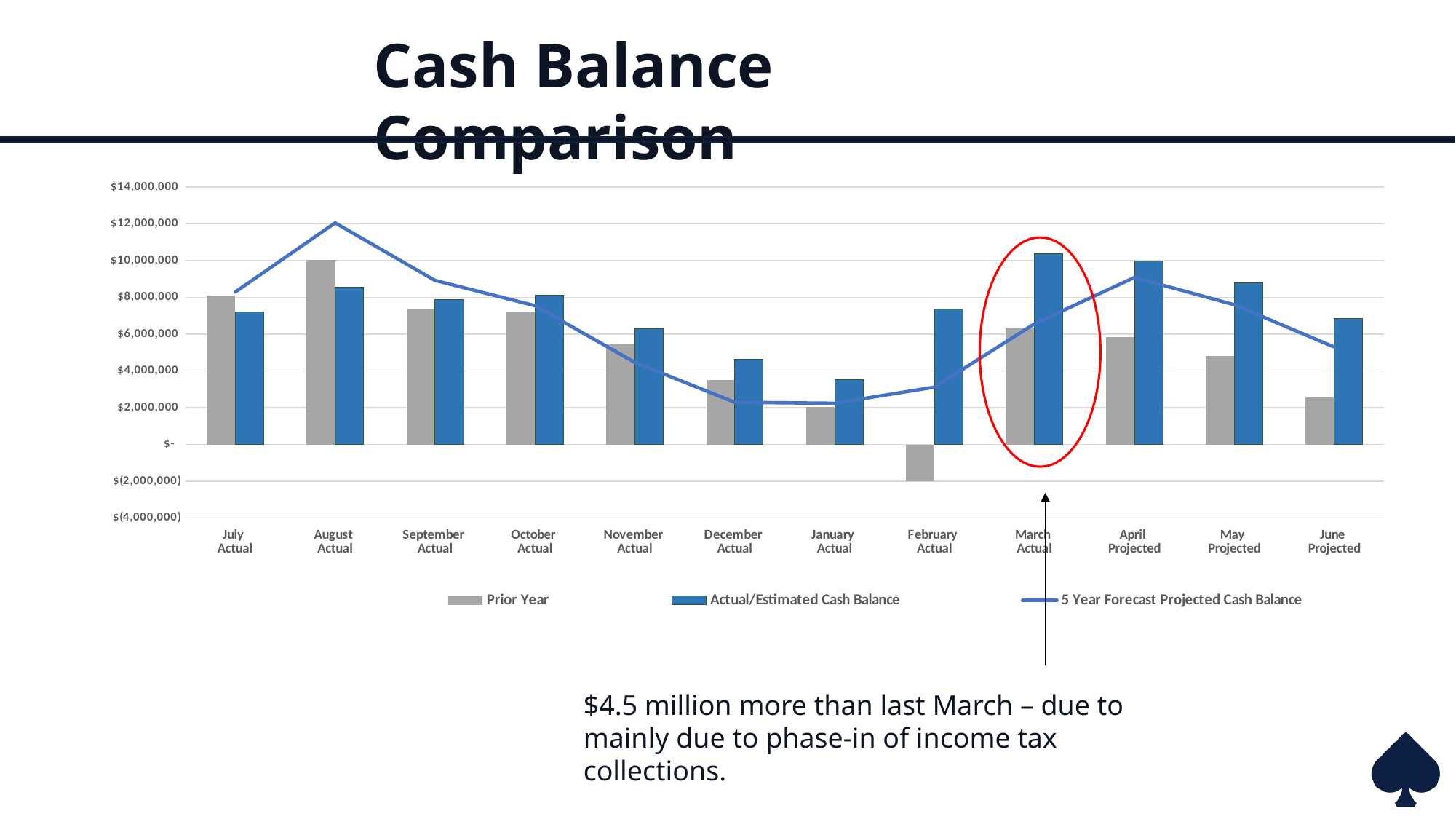
In which month is the Prior Year value lowest? February Actual In which month is the Prior Year value highest? August Actual Is the Prior Year value for August Actual greater or less than $8,000,000? greater Does the 5 Year Forecast Projected Cash Balance line rise or fall from August Actual to January Actual? fall How many months are shown along the x axis? 12 How many series does the legend list? 3 Is the Actual/Estimated Cash Balance for January Actual greater or less than $4,000,000? less In which month is the Actual/Estimated Cash Balance lowest? January Actual Is the Prior Year value for February Actual greater or less than $0? less Which month's bars are circled in red on the chart? March Actual What kind of chart is shown on the slide? bar chart with a line For March Actual, which is larger: the Prior Year bar or the Actual/Estimated Cash Balance bar? Actual/Estimated Cash Balance